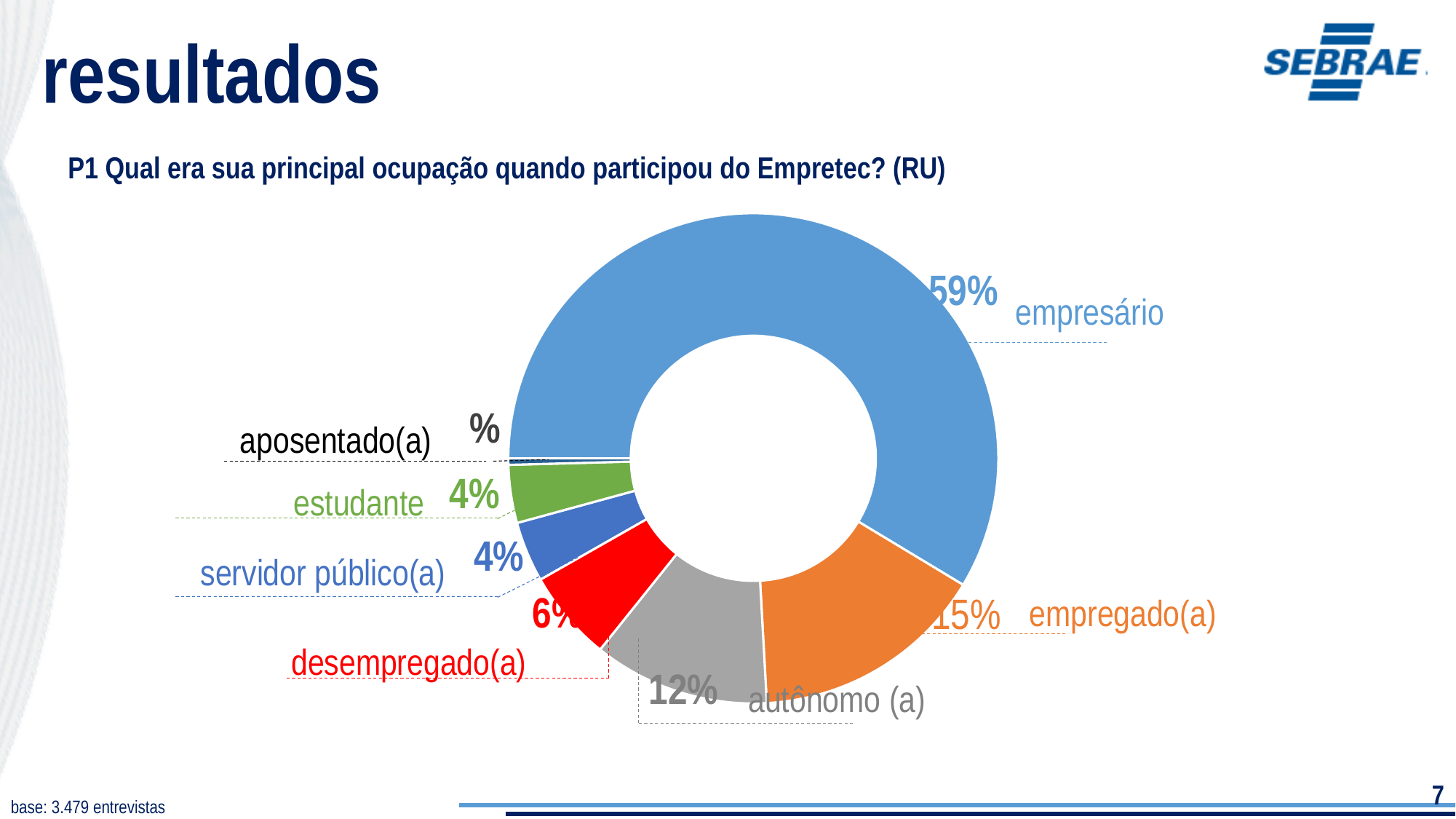
What percentage of respondents were empresário? 59% What kind of chart is shown on the slide? pie chart (donut) What is the difference in percentage points between empresário and empregado(a)? 44 percentage points What percentage of respondents were estudante? 4% Which occupation category has the largest share of the pie? empresário How many occupation categories are shown in the chart? 7 What is the survey question shown above the chart? P1 Qual era sua principal ocupação quando participou do Empretec? (RU) What percentage of respondents were desempregado(a)? 6% What percentage of respondents were empregado(a)? 15% What percentage of respondents were autônomo (a)? 12% Which occupation category has the smallest share of the pie? aposentado(a) Which is larger, the share for empregado(a) or the share for autônomo (a)? empregado(a)